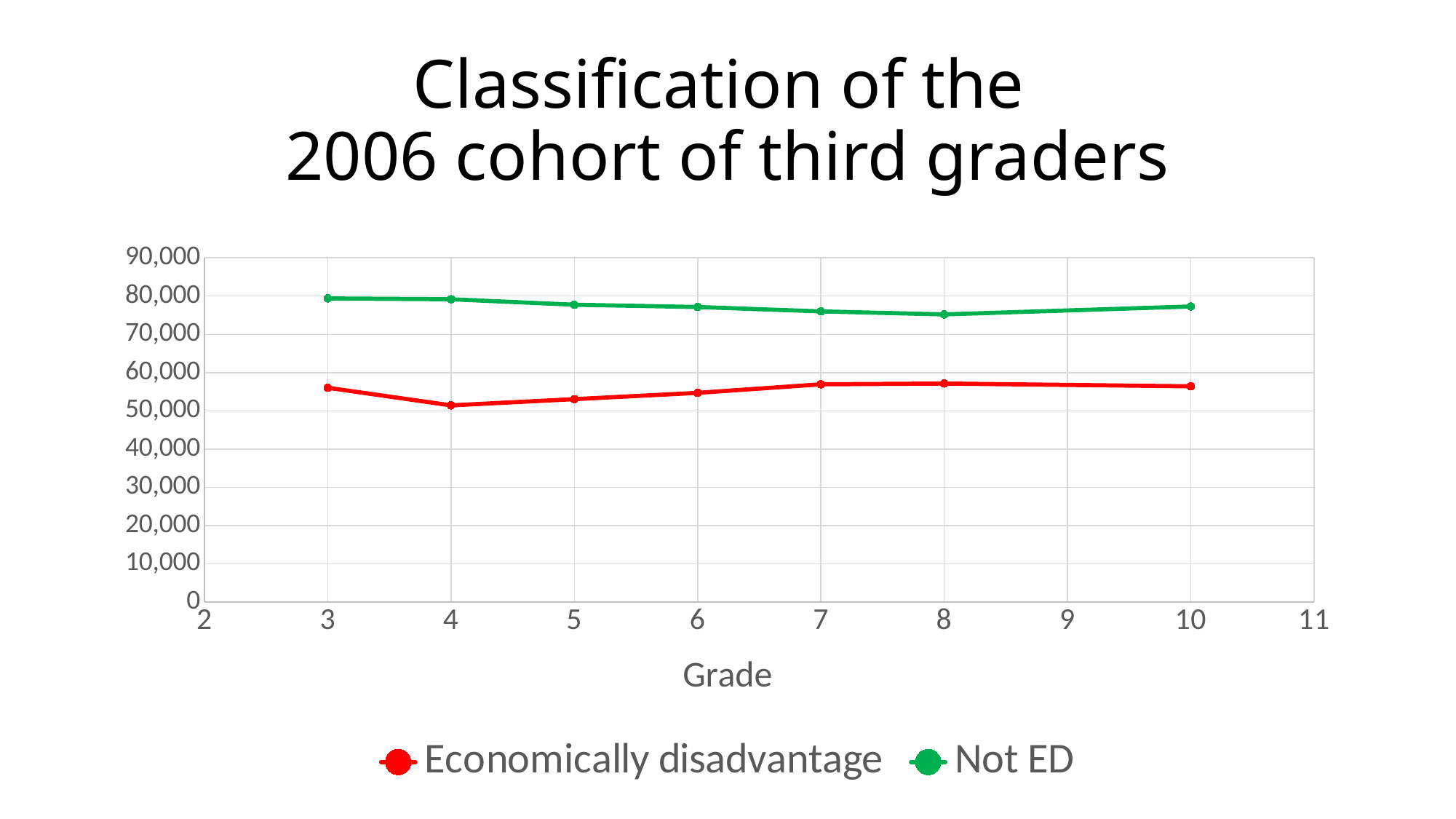
Is the value for Not ED at grade 8 greater or less than 80,000? less Is the value for Not ED at grade 3 greater or less than 70,000? greater How many grade points are plotted for each series? 7 Does the Not ED series rise or fall from grade 3 to grade 8? Fall What kind of chart is shown on the slide? Line chart At grade 6, which series has the larger value, Economically disadvantage or Not ED? Not ED Is the value for Economically disadvantage at grade 7 greater or less than 50,000? greater What is the title of the chart? Classification of the 2006 cohort of third graders At which grade is the Economically disadvantage series at its lowest? 4 How many series does the legend list? 2 What is the label on the x axis? Grade